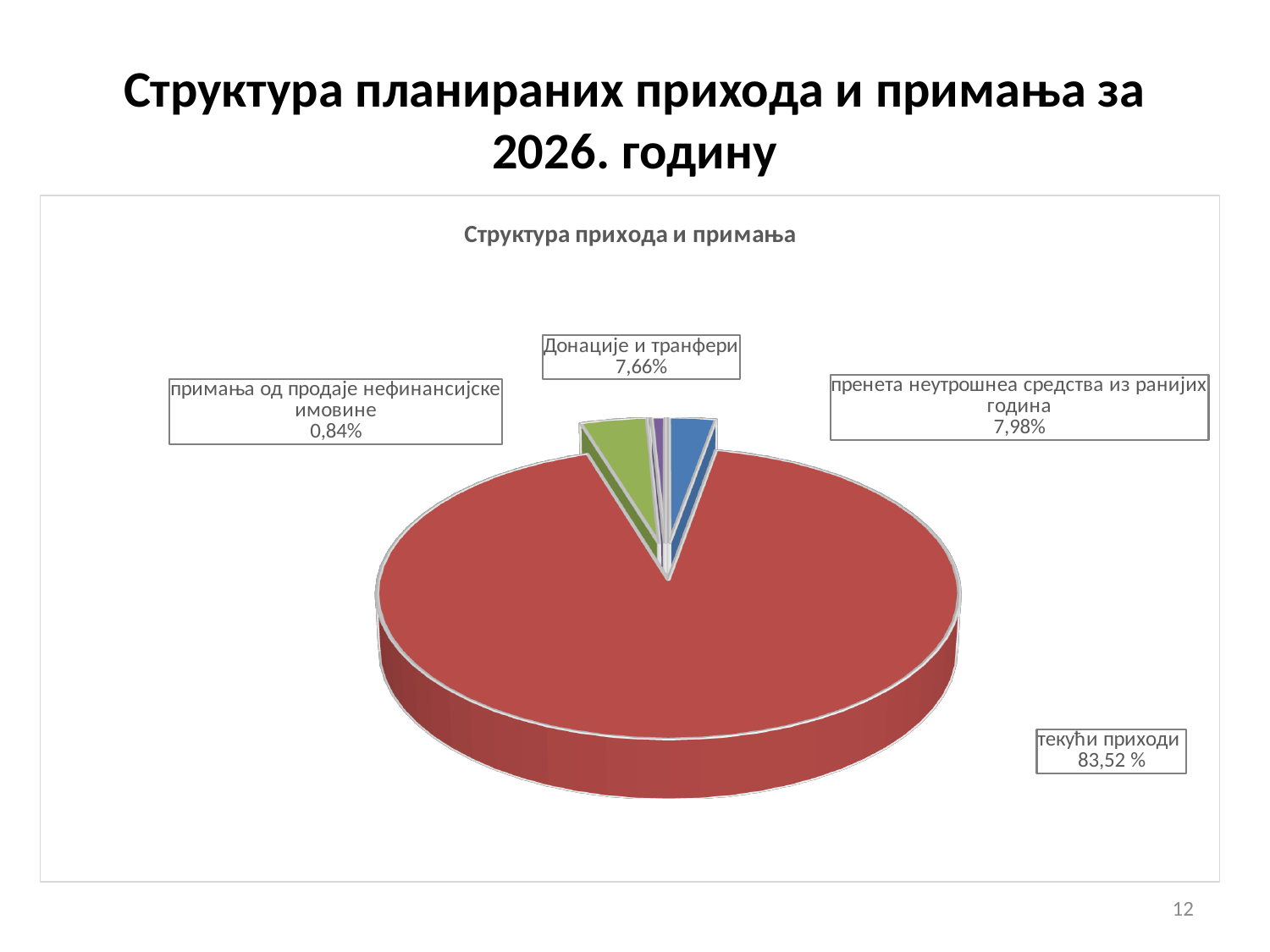
What percentage is shown for Донације и транфери? 7,66% Which category has the smallest share of the pie? примања од продаје нефинансијске имовине What percentage is shown for пренета неутрошнеа средства из ранијих година? 7,98% What is the difference in percentage points between пренета неутрошнеа средства из ранијих година and Донације и транфери? 0,32 Which is larger: the share for пренета неутрошнеа средства из ранијих година or the share for Донације и транфери? пренета неутрошнеа средства из ранијих година What type of chart is shown on the slide? Pie chart How many slices does the pie chart have? 4 What colour is the slice for текући приходи? Red What share of the pie is labelled for текући приходи? 83,52 % Which category has the largest share of the pie? текући приходи What is the chart's title? Структура прихода и примања What percentage is shown for примања од продаје нефинансијске имовине? 0,84%